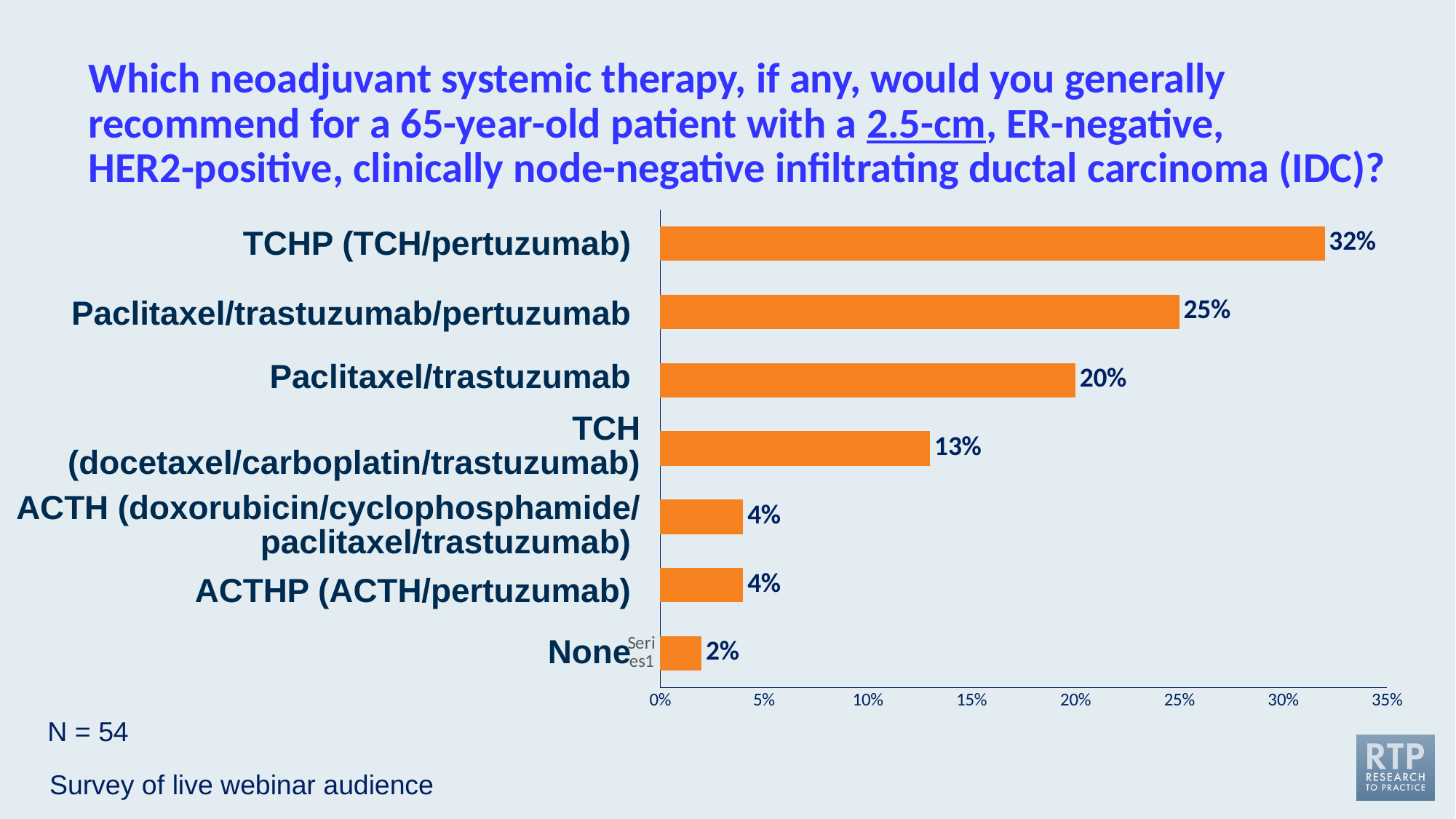
What is the difference in percentage points between TCHP (TCH/pertuzumab) and Paclitaxel/trastuzumab? 12% What percentage of respondents chose TCHP (TCH/pertuzumab)? 32% Which option received the highest percentage of responses? TCHP (TCH/pertuzumab) What type of chart is shown on the slide? Bar chart How many response options are shown in the chart? 7 What percentage of respondents chose Paclitaxel/trastuzumab/pertuzumab? 25% What percentage of respondents chose TCH (docetaxel/carboplatin/trastuzumab)? 13% Is the value for Paclitaxel/trastuzumab/pertuzumab greater or less than 20%? greater Which received a larger share of responses, Paclitaxel/trastuzumab or TCH (docetaxel/carboplatin/trastuzumab)? Paclitaxel/trastuzumab Which option received the lowest percentage of responses? None What percentage of respondents chose None? 2% What is the maximum value shown on the horizontal axis? 35%